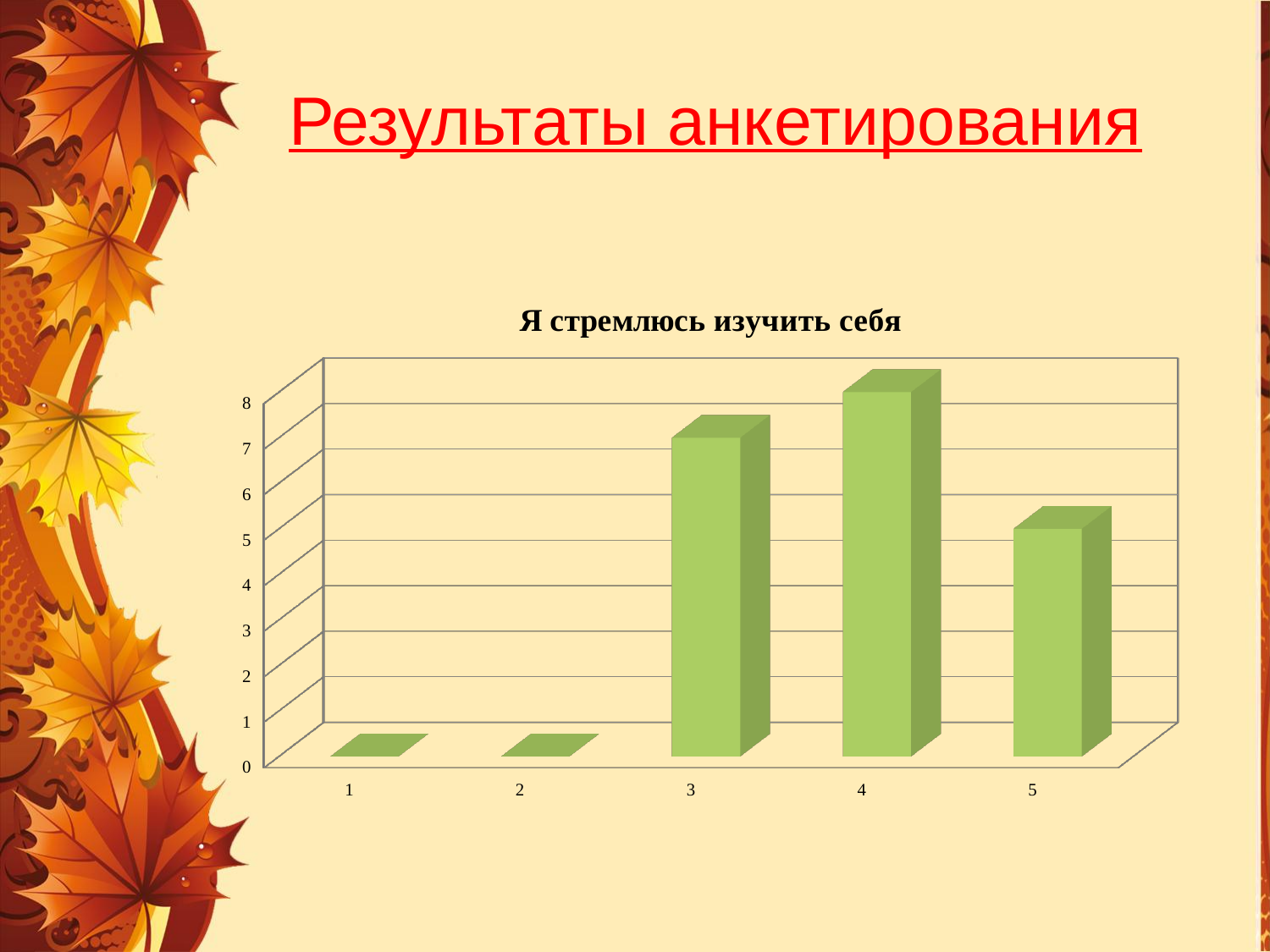
What colour are the bars in the chart? green Is the value for category 3 greater or less than 6? greater Which is larger, the value for category 3 or the value for category 5? category 3 Is the value for category 5 greater or less than 6? less Which is larger, the value for category 4 or the value for category 3? category 4 What is the title of the chart? Я стремлюсь изучить себя What is the value for category 1? 0 Which category has the highest bar in the chart? 4 What is the value for category 2? 0 Is the value for category 4 greater or less than 7? greater How many categories are shown on the x axis of the chart? 5 What kind of chart is shown on the slide? bar chart